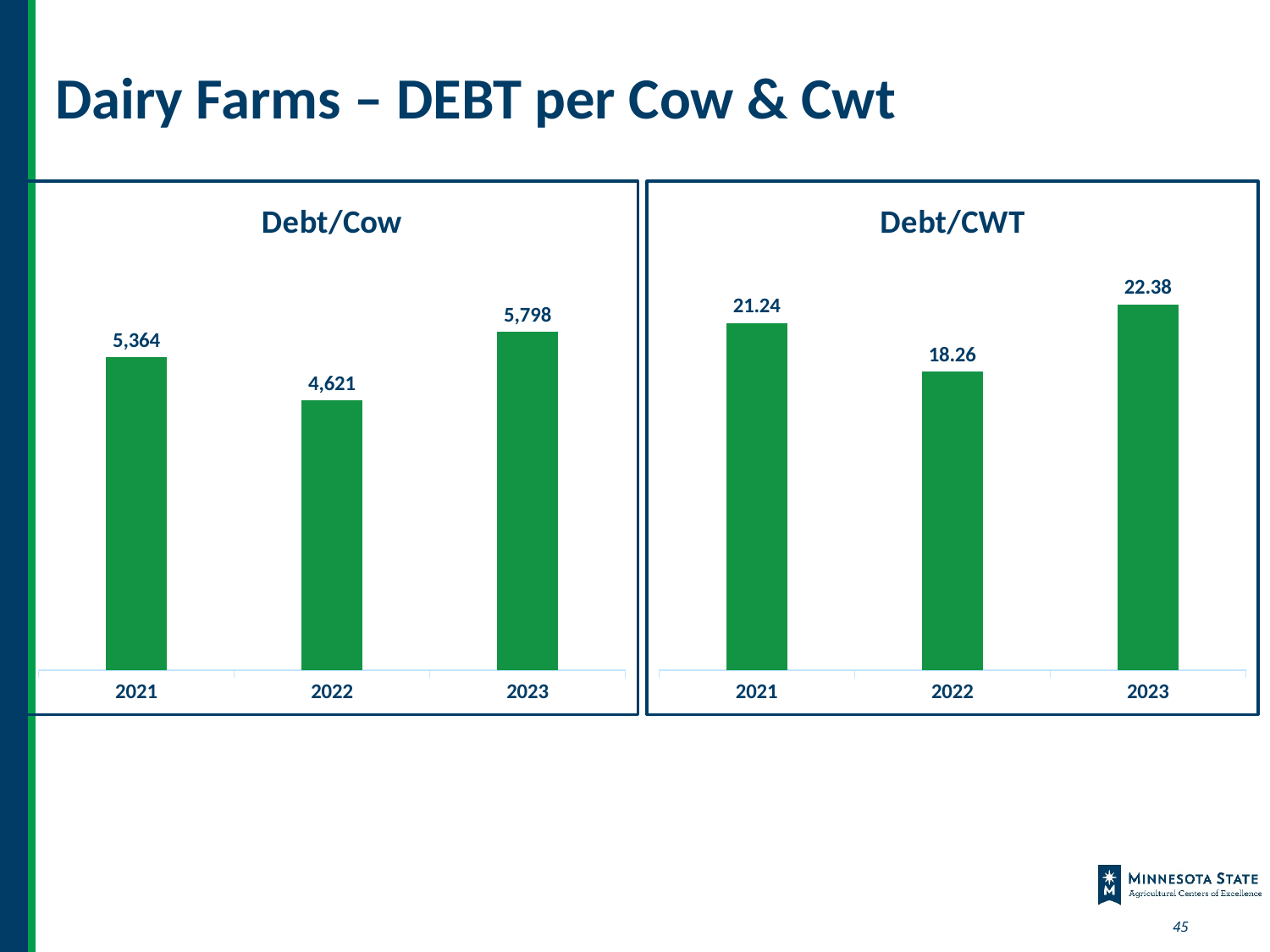
What is the title of the chart on the right side of the slide? Debt/CWT What kind of chart is the Debt/CWT chart? Bar chart In the Debt/Cow chart, what is the difference between the 2023 and 2021 values? 434 How many years are shown in the Debt/Cow chart? 3 In the Debt/CWT chart, which year has the lowest value? 2022 In the Debt/Cow chart, which year has the highest value? 2023 In the Debt/CWT chart, what is the difference between the 2021 and 2022 values? 2.98 In the Debt/CWT chart, which is larger, the value for 2023 or the value for 2021? 2023 In the Debt/Cow chart, what is the value for 2022? 4,621 In the Debt/CWT chart, what is the value for 2023? 22.38 In the Debt/Cow chart, what is the value for 2021? 5,364 In the Debt/Cow chart, which is larger, the value for 2021 or the value for 2022? 2021